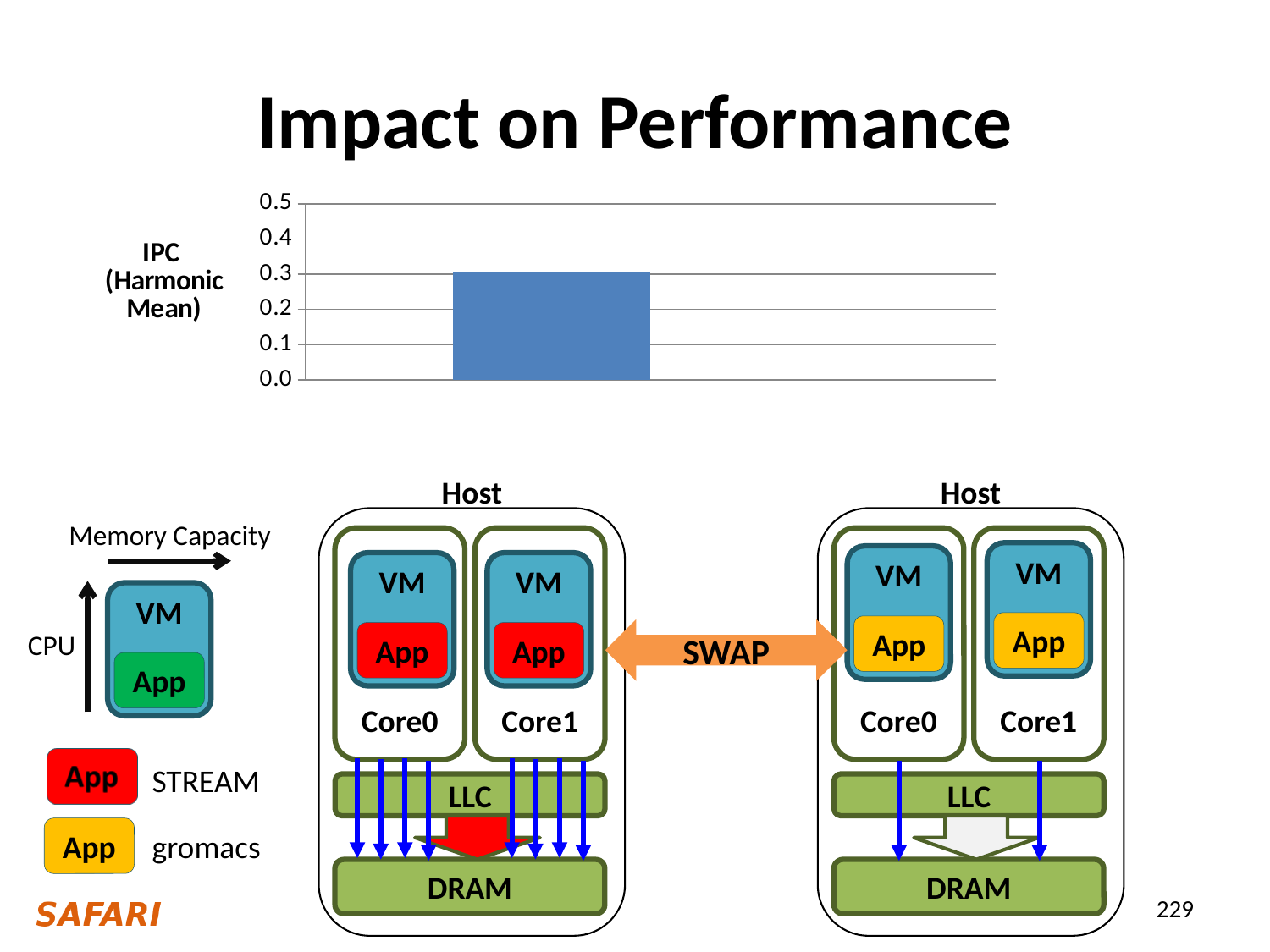
Is the value of the bar in the chart greater or less than 0.2? greater What is the highest value shown on the chart's vertical axis? 0.5 What is the label on the vertical axis of the chart? IPC (Harmonic Mean) How many bars are plotted in the chart? 1 What kind of chart is shown on the slide? bar chart Is the value of the bar in the chart greater or less than 0.1? greater Is the value of the bar in the chart greater or less than 0.4? less